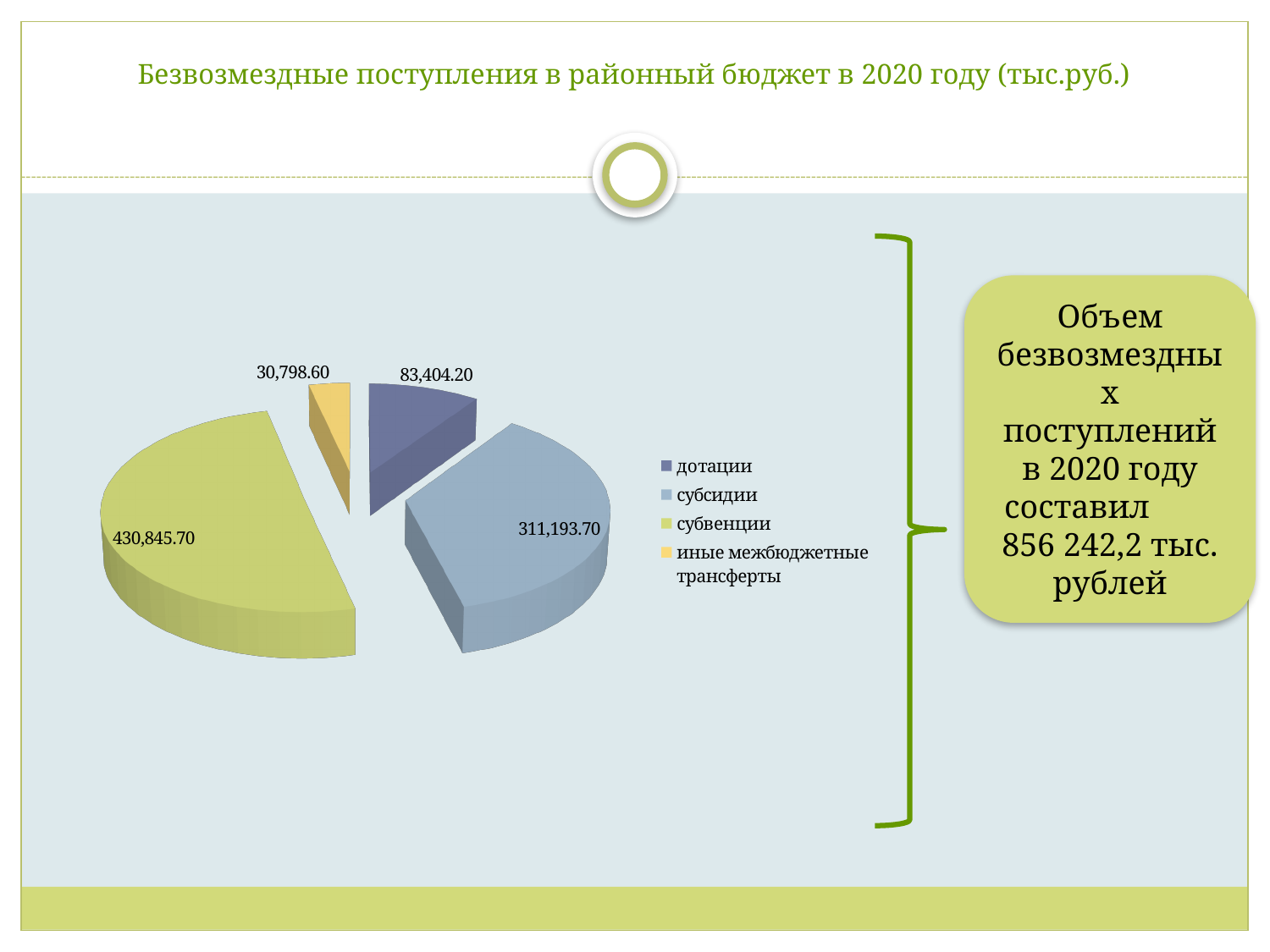
What is the value for субсидии? 311,193.70 What is the value for дотации? 83,404.20 What is the difference between the values for субвенции and субсидии? 119,652.00 Which category has the smallest slice of the pie? иные межбюджетные трансферты What is the value for субвенции? 430,845.70 How many categories does the pie chart have? 4 What is the value for иные межбюджетные трансферты? 30,798.60 What is the title of the slide containing the chart? Безвозмездные поступления в районный бюджет в 2020 году (тыс.руб.) Which is larger, the value for дотации or the value for субсидии? субсидии What is the difference between the values for дотации and иные межбюджетные трансферты? 52,605.60 Which category has the largest slice of the pie? субвенции What kind of chart is shown on the slide? Pie chart